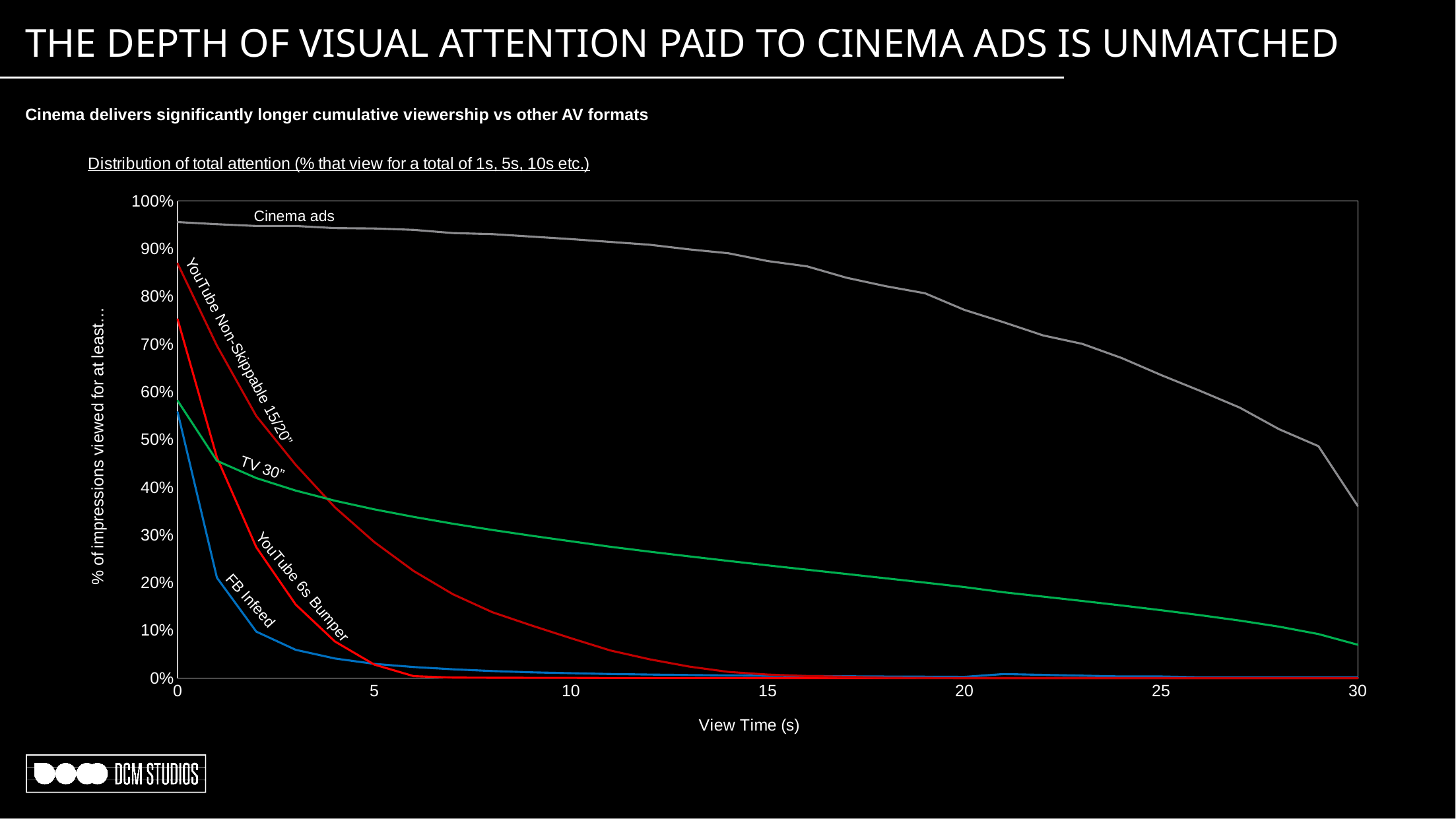
What is the label of the x axis? View Time (s) Is the value for TV 30" at 30 seconds greater or less than 10%? less What kind of chart is shown on the slide? Line chart Does the Cinema ads line rise or fall as view time increases? Fall How many series (lines) are plotted on the chart? 5 Which series has the highest value at 30 seconds? Cinema ads Is the value for YouTube 6s Bumper at 0 seconds greater or less than 70%? greater Is the value for Cinema ads at 30 seconds greater or less than 30%? greater What is the chart's title (the underlined heading above the chart)? Distribution of total attention (% that view for a total of 1s, 5s, 10s etc.) At 30 seconds, which is higher: Cinema ads or TV 30"? Cinema ads